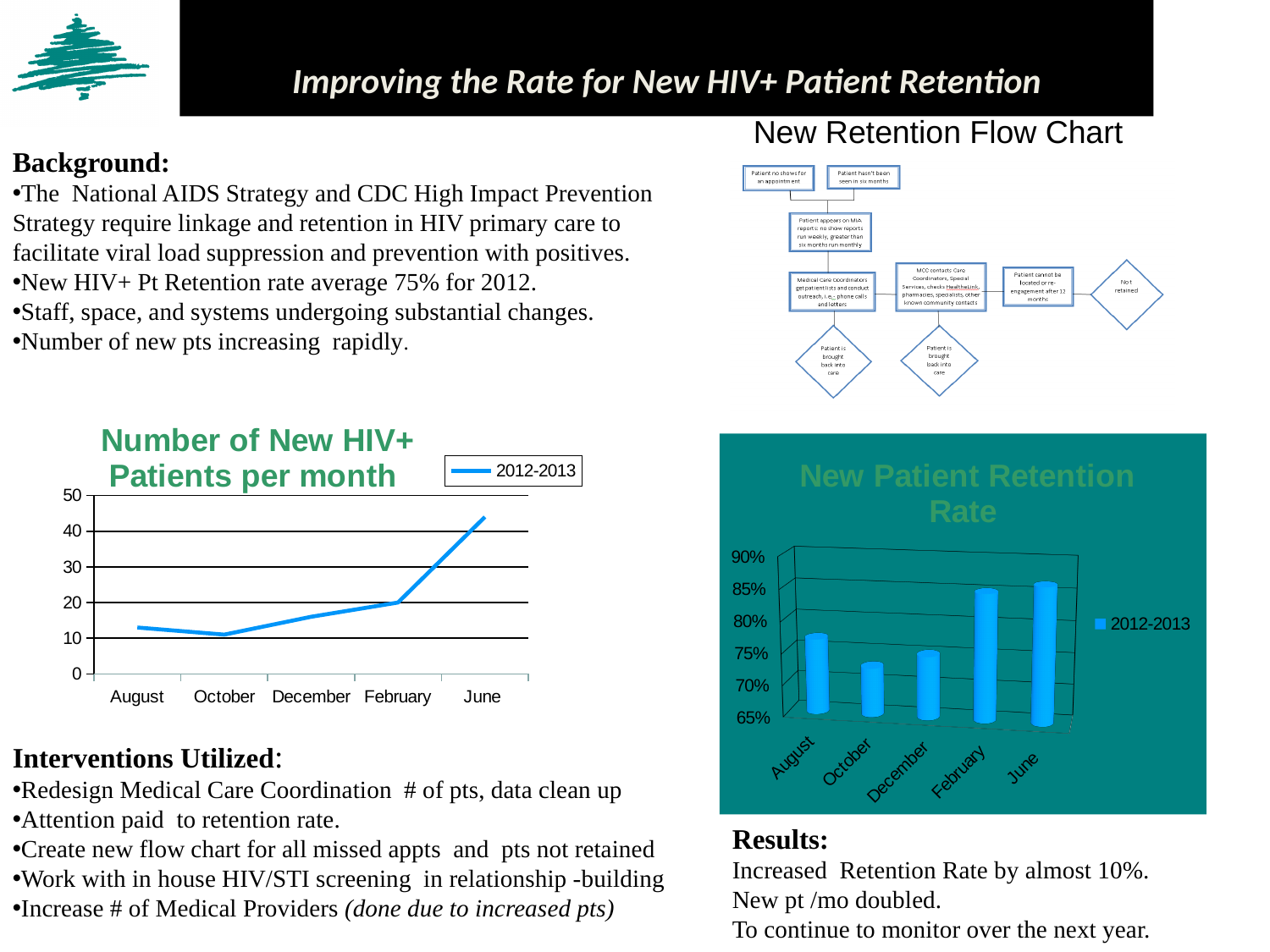
What kind of chart is the "New Patient Retention Rate" chart? bar chart In the "Number of New HIV+ Patients per month" chart, which month has the highest value? June How many series does the legend of the "New Patient Retention Rate" chart list? 1 In the "Number of New HIV+ Patients per month" chart, how many months are shown on the x axis? 5 In the "Number of New HIV+ Patients per month" chart, which month has the lowest value? October In the "Number of New HIV+ Patients per month" chart, is the value for August greater or less than 20? less In the "Number of New HIV+ Patients per month" chart, is the value for June greater or less than 40? greater What series name appears in the legend of the "Number of New HIV+ Patients per month" chart? 2012-2013 What kind of chart is the "Number of New HIV+ Patients per month" chart? line chart In the "New Patient Retention Rate" chart, which month has the lowest retention rate? October In the "New Patient Retention Rate" chart, which is larger, the value for February or the value for October? February In the "New Patient Retention Rate" chart, is the value for February greater or less than 80%? greater